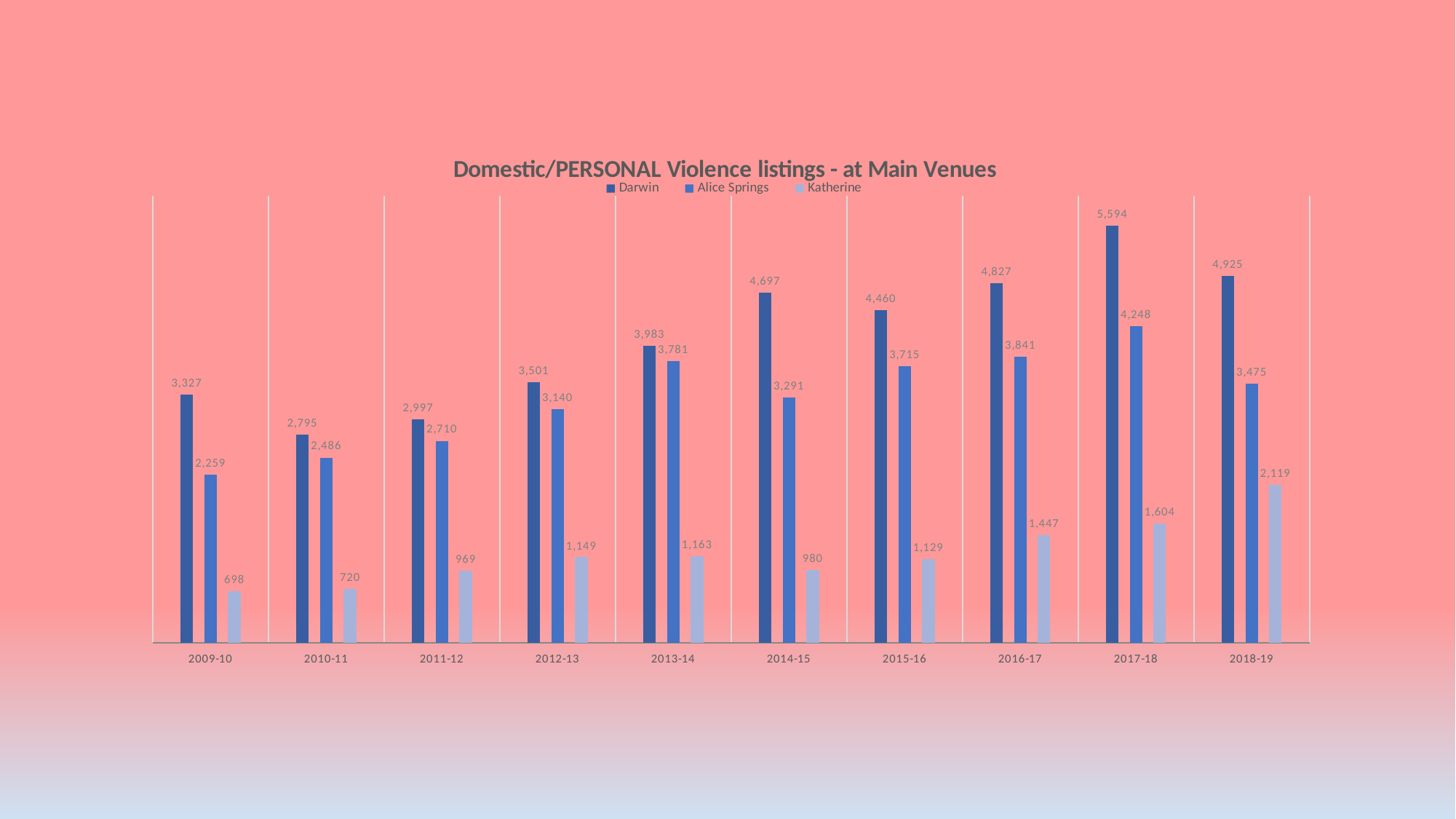
Which is larger in 2013-14: the Darwin value or the Alice Springs value? Darwin What is the value for Katherine in 2009-10? 698 How many series does the legend list? 3 In which year is the Katherine value lowest? 2009-10 What is the value for Darwin in 2017-18? 5,594 What is the difference between the Darwin and Alice Springs values in 2018-19? 1,450 What is the title of the chart? Domestic/PERSONAL Violence listings - at Main Venues What kind of chart is shown on the slide? Bar chart Does the Katherine value rise or fall from 2015-16 to 2018-19? Rise What is the value for Alice Springs in 2014-15? 3,291 In which year is the Darwin value highest? 2017-18 How many years are shown on the x axis? 10